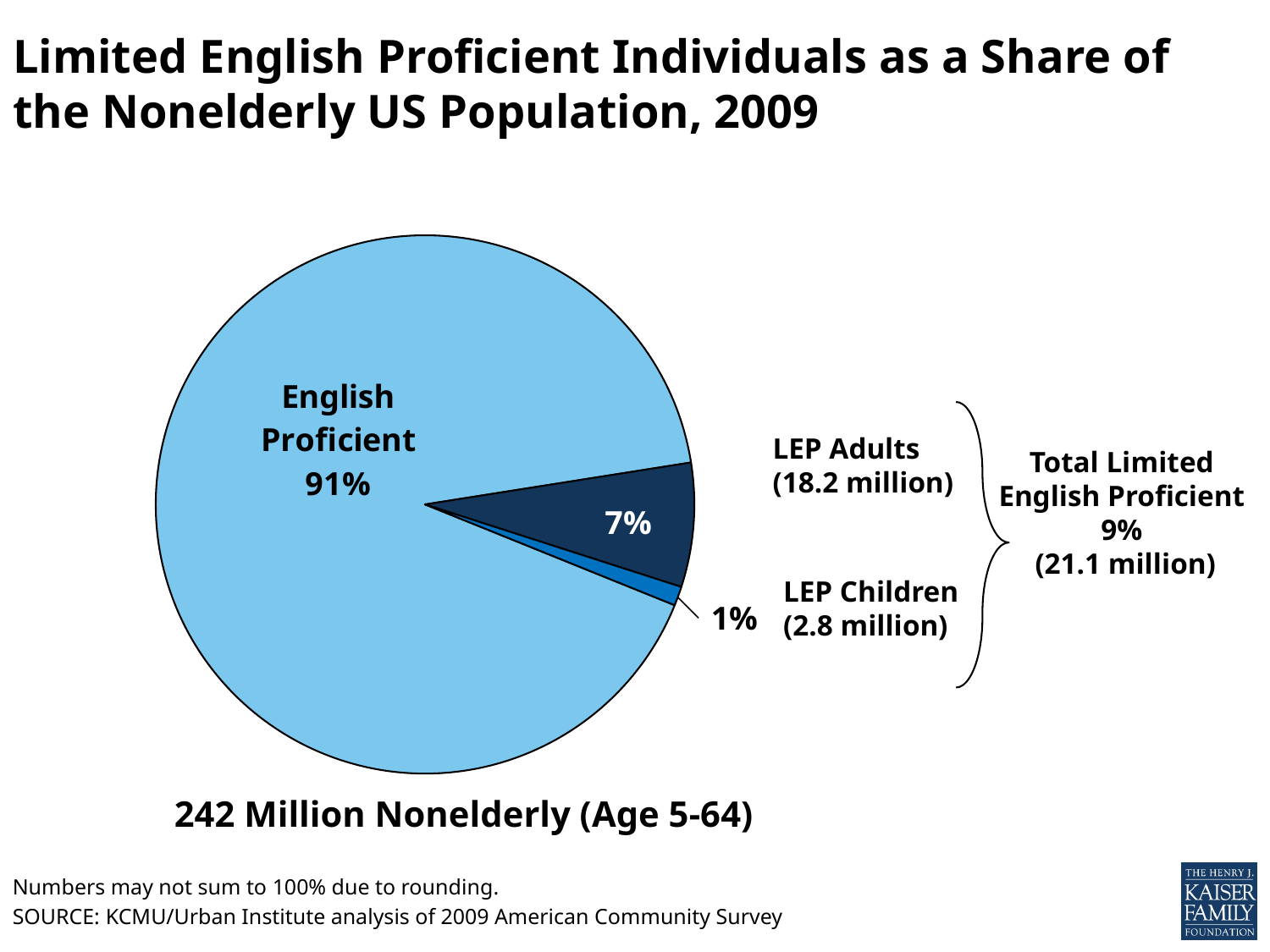
How many people in total are Limited English Proficient according to the slide? 21.1 million How many slices does the pie chart have? 3 What share of the nonelderly US population is English Proficient? 91% What share of the pie is LEP Adults? 7% What kind of chart is shown on the slide? Pie chart How many people are LEP Adults according to the chart? 18.2 million How many people are LEP Children according to the chart? 2.8 million Which slice of the pie is the largest? English Proficient What is the total share of Limited English Proficient individuals shown on the slide? 9% What is the difference in percentage points between the English Proficient slice and the LEP Adults slice? 84 percentage points What share of the pie is LEP Children? 1% Which slice of the pie is the smallest? LEP Children